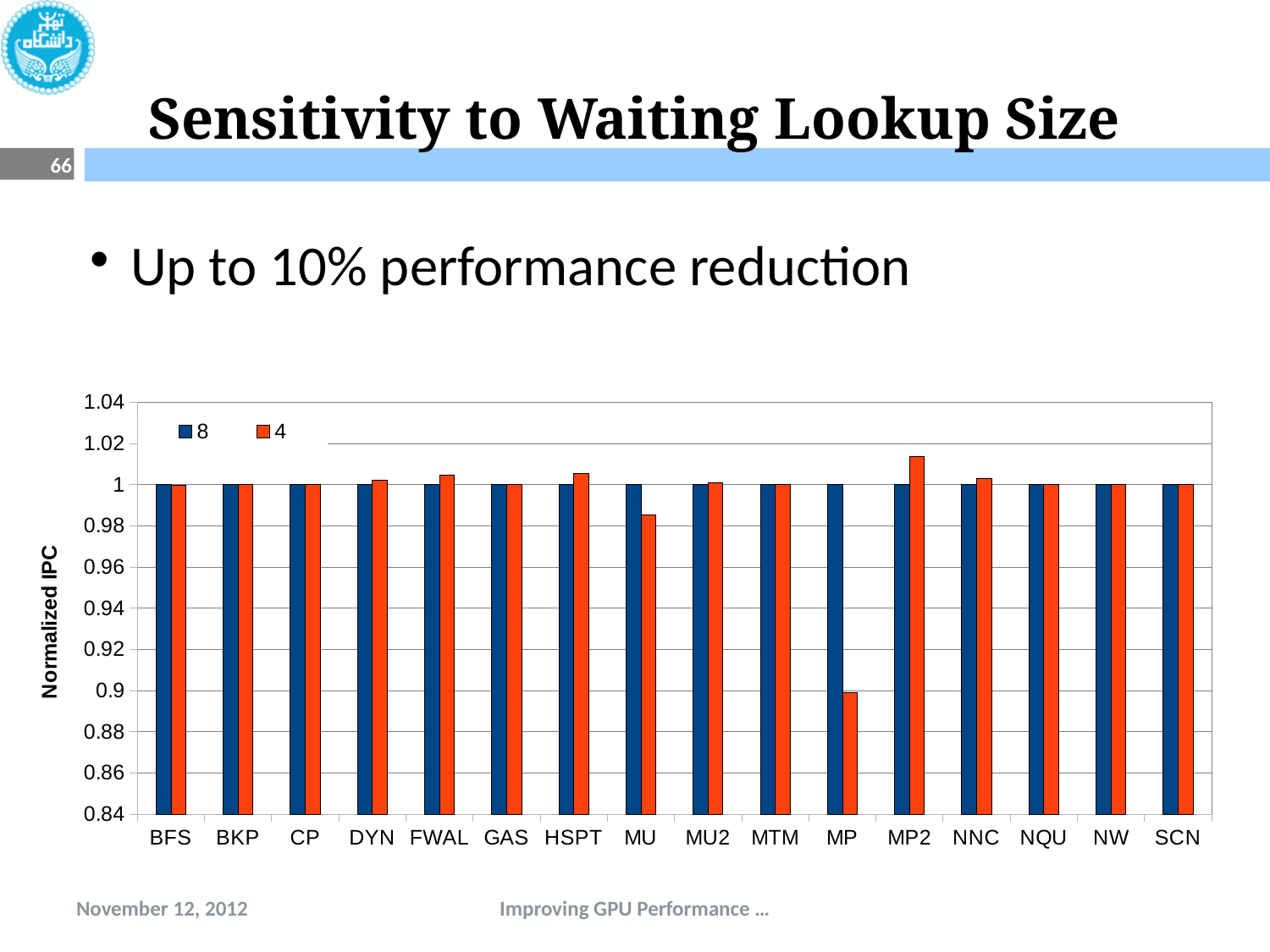
What are the two series names in the legend? 8 and 4 How many categories (benchmarks) are shown on the x axis? 16 What is the value for BFS in series 8? 1 What is the y-axis title of the chart? Normalized IPC Which category has the highest value for series 4? MP2 How many series does the legend list? 2 Is the value for MP in series 4 greater or less than 0.92? less Is the value for MU in series 4 greater or less than 1? less Is the value for MP2 in series 4 greater or less than 1? greater Which category has the lowest value for series 4? MP What kind of chart is shown on the slide? bar chart Which is larger for series 4: the value for MP or the value for MP2? MP2